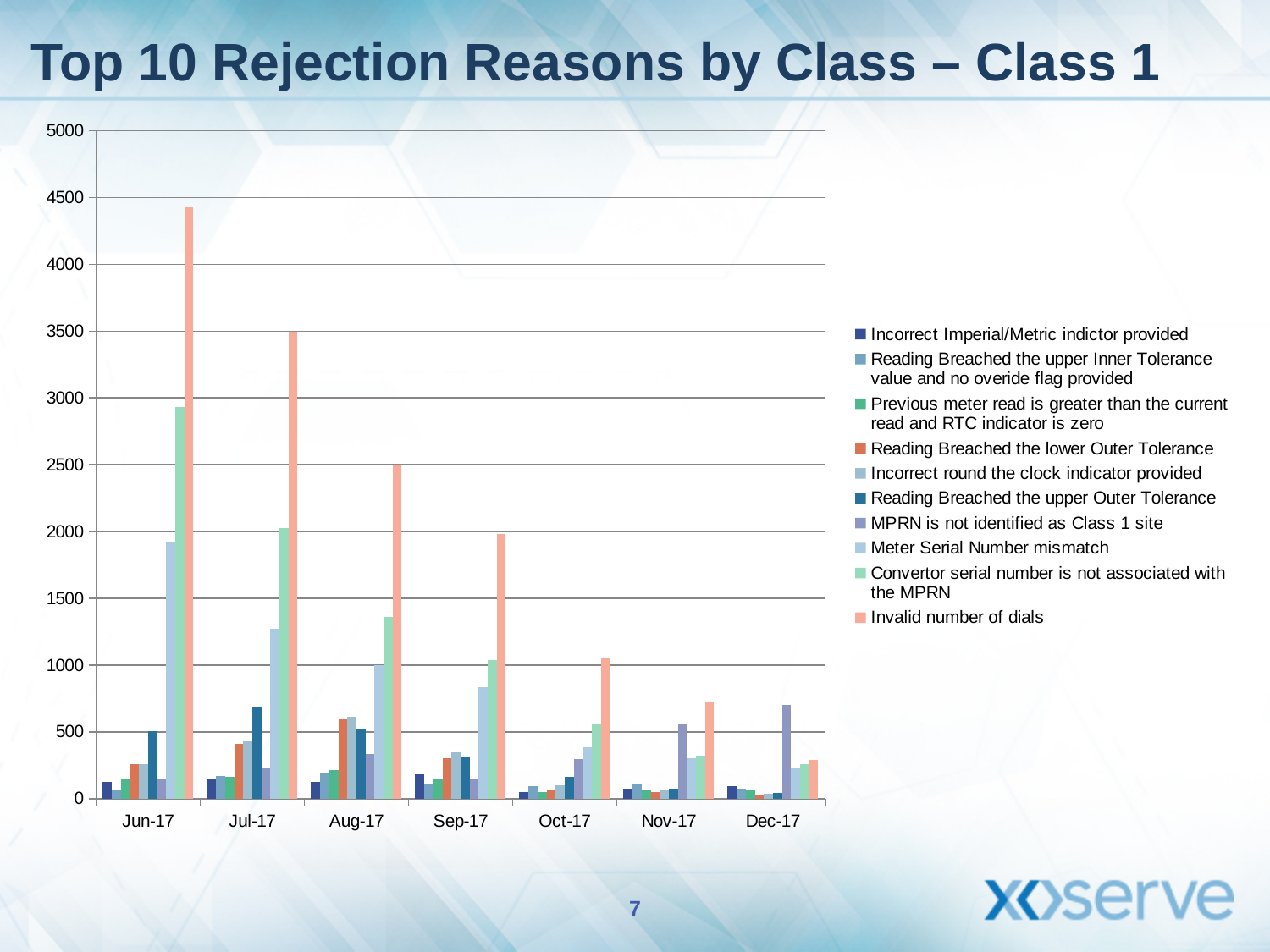
Does the value for 'Invalid number of dials' rise or fall from Jun-17 to Dec-17? Fall Which rejection reason has the tallest bar in Jun-17? Invalid number of dials Is the value for 'MPRN is not identified as Class 1 site' in Dec-17 greater or less than 500? greater In which month is the value for 'Invalid number of dials' highest? Jun-17 Is the value for 'Convertor serial number is not associated with the MPRN' in Aug-17 greater or less than 1000? greater How many series does the legend list? 10 How many months are shown on the x axis of the chart? 7 Which is larger: 'Invalid number of dials' in Jun-17 or 'Invalid number of dials' in Jul-17? Jun-17 What is the title of the slide containing the chart? Top 10 Rejection Reasons by Class – Class 1 Is the value for 'Invalid number of dials' in Dec-17 greater or less than 500? less What kind of chart is shown on the slide? Bar chart